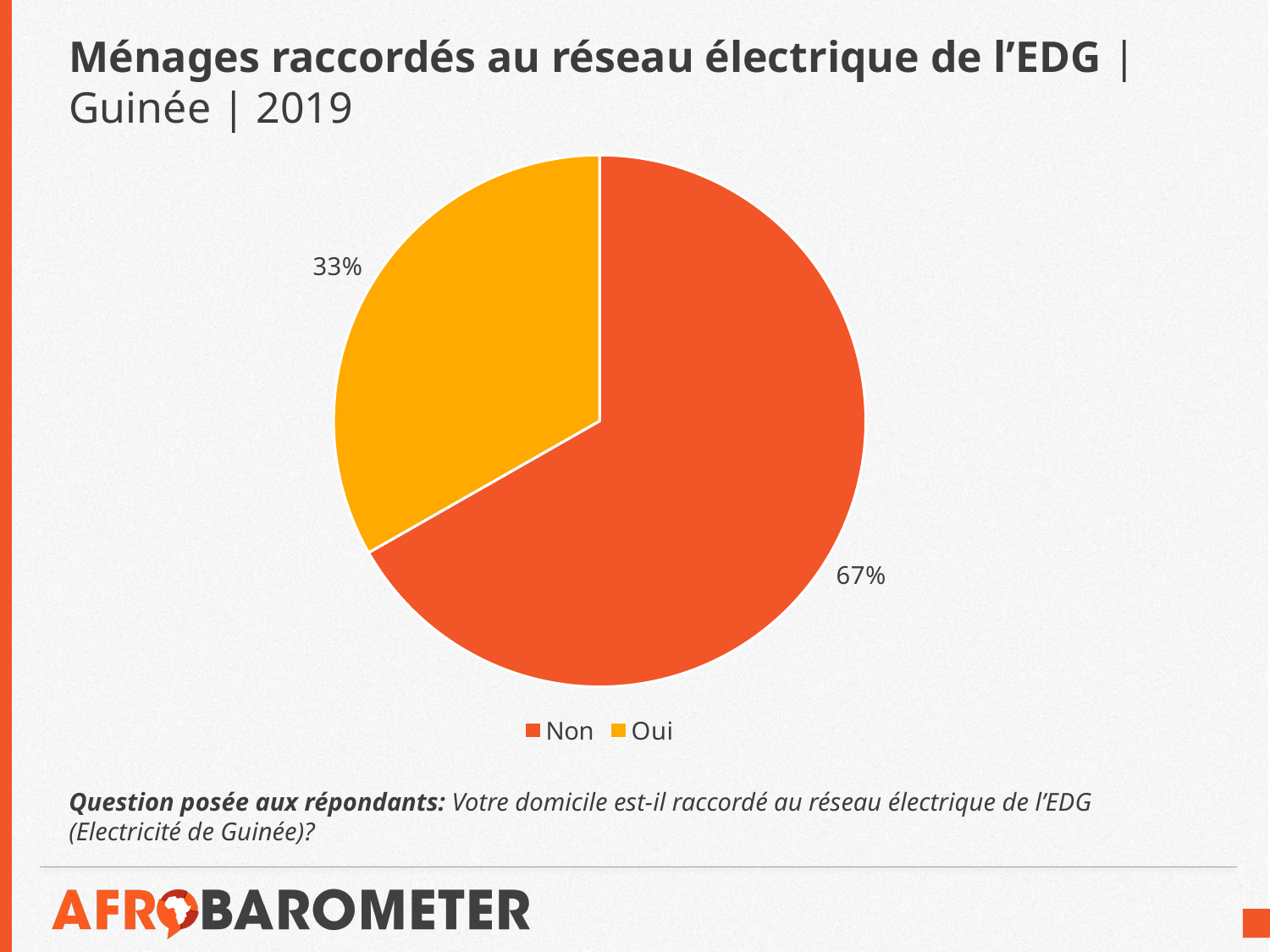
What share of the pie does the "Oui" slice represent? 33% What colour is the "Oui" slice? Yellow What kind of chart is shown on the slide? Pie chart Which is larger, the "Oui" slice or the "Non" slice? Non How many slices does the pie chart have? 2 What is the difference in percentage points between the "Non" and "Oui" slices? 34 Which response has the smallest share of the pie? Oui What percentage of respondents answered "Non"? 67% Which country and year does the chart title refer to? Guinée, 2019 Which response has the largest share of the pie? Non What percentage of respondents answered "Oui"? 33% How many entries does the legend list? 2